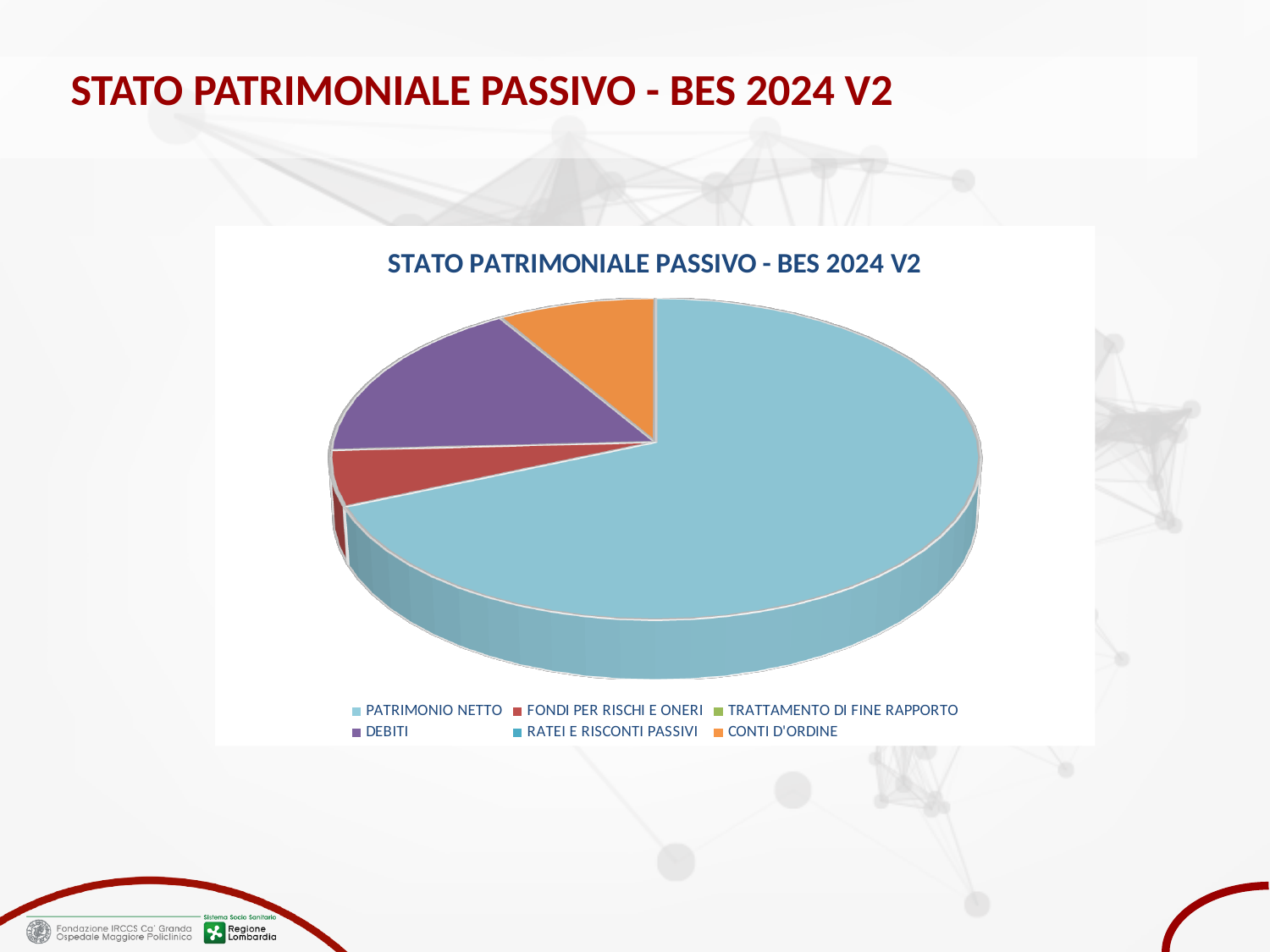
Which is larger, the slice for DEBITI or the slice for FONDI PER RISCHI E ONERI? DEBITI Which is larger, the slice for PATRIMONIO NETTO or the slice for DEBITI? PATRIMONIO NETTO What kind of chart is shown on the slide? pie chart What colour is the slice for PATRIMONIO NETTO? light blue How many categories does the chart legend list? 6 What is the title of the chart? STATO PATRIMONIALE PASSIVO - BES 2024 V2 Which category has the largest slice of the pie? PATRIMONIO NETTO Which is larger, the slice for CONTI D'ORDINE or the slice for FONDI PER RISCHI E ONERI? CONTI D'ORDINE